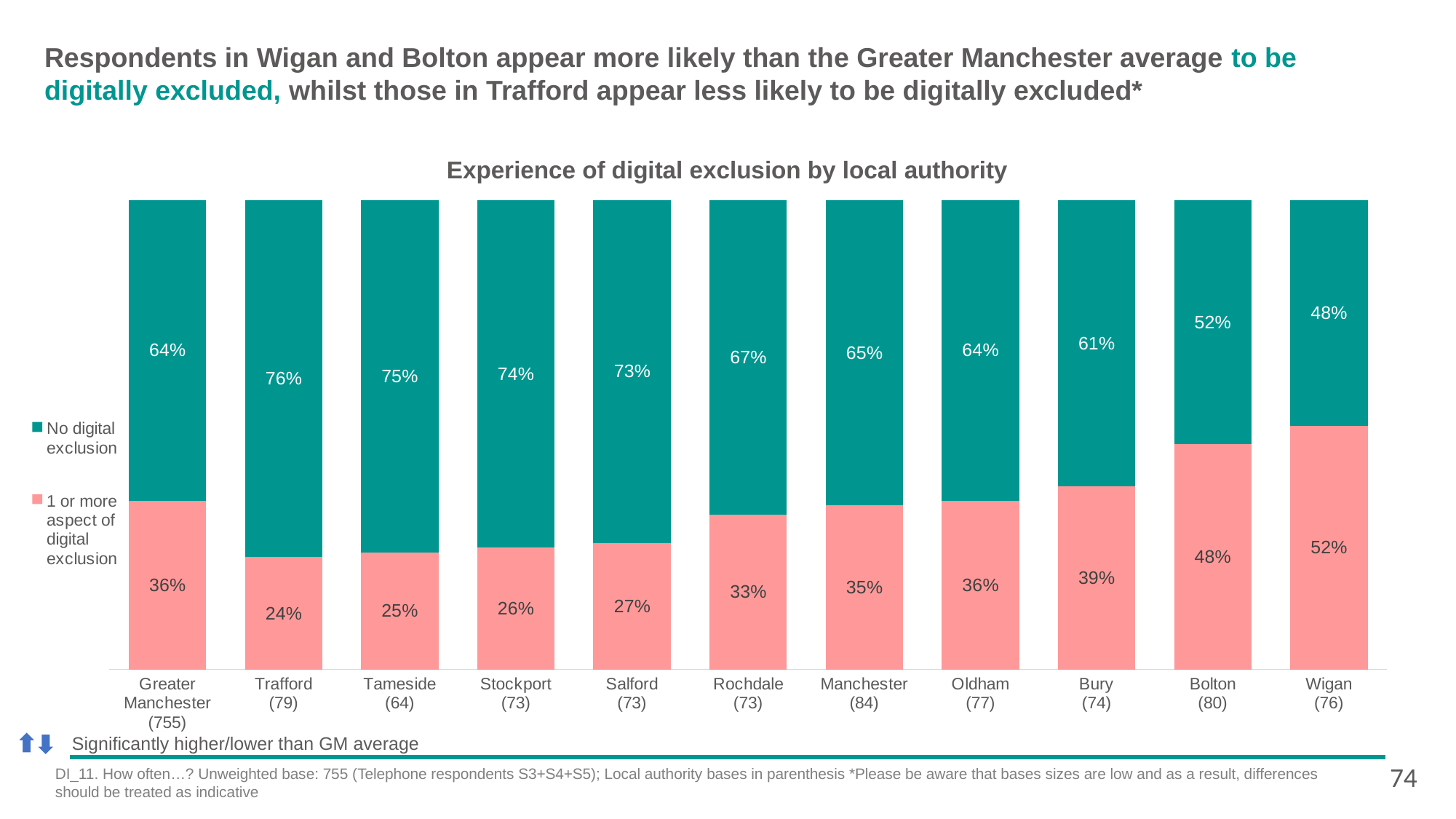
How many local authority categories (including Greater Manchester) are shown on the x axis? 11 What is the 'No digital exclusion' value for Trafford? 76% Which local authority has the highest share of respondents with 1 or more aspect of digital exclusion? Wigan Which local authority has the lowest share of respondents with 1 or more aspect of digital exclusion? Trafford What is the difference between Bolton's and Greater Manchester's '1 or more aspect of digital exclusion' values? 12 percentage points How many series does the legend list? 2 What kind of chart is shown on the slide? Stacked bar chart What is the total of the stacked bar for Rochdale? 100% What is the '1 or more aspect of digital exclusion' value for Greater Manchester? 36% Which has a higher 'No digital exclusion' value, Salford or Bury? Salford What percentage of respondents in Wigan report 1 or more aspect of digital exclusion? 52% What is the title of the chart? Experience of digital exclusion by local authority